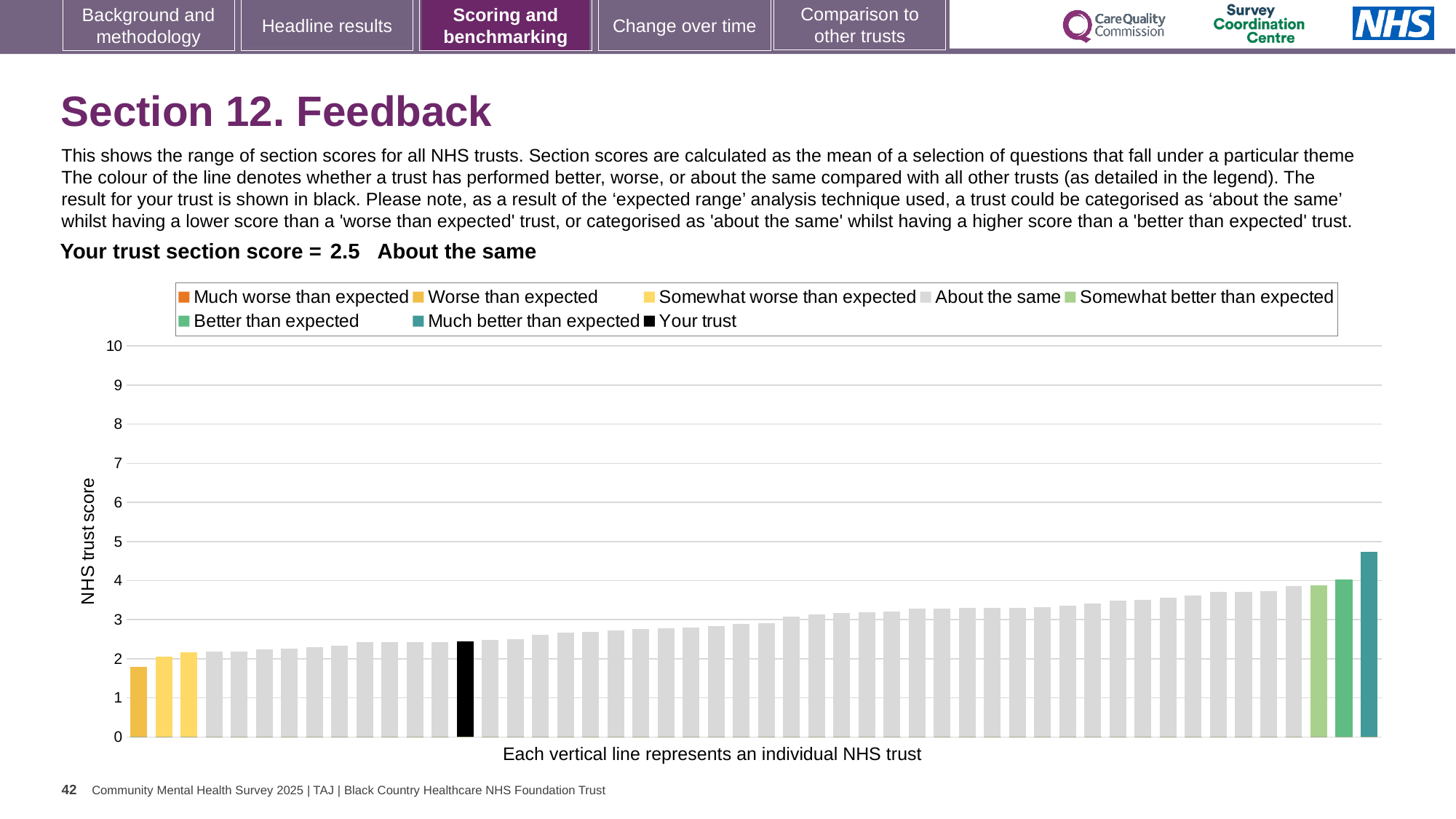
What is the label on the vertical axis of the chart? NHS trust score Is the value of the shortest bar in the chart greater or less than 2? less Do the bar values rise or fall from left to right along the x axis? rise What is the section score for your trust shown on the slide? 2.5 Is the value of the tallest bar in the chart greater or less than 4? greater Which legend category does the tallest bar in the chart belong to? Much better than expected Which category is your trust placed in for this section? About the same What is the highest value shown on the vertical axis? 10 Is the value for your trust (the black bar) greater or less than 3? less How many entries does the chart legend list? 8 What kind of chart is shown on the slide? bar chart What does each vertical line in the chart represent, according to the x-axis label? an individual NHS trust